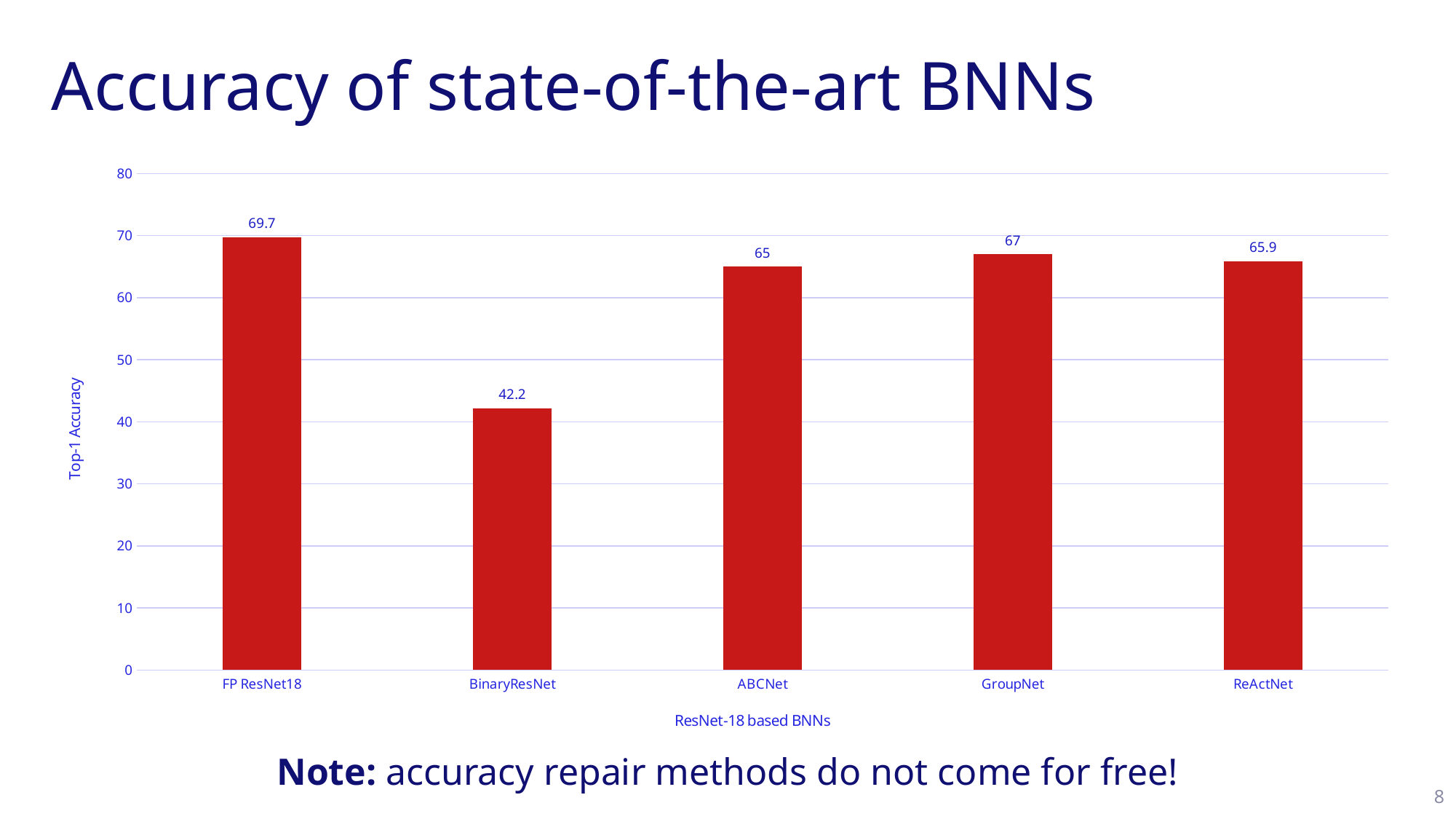
Which has a higher Top-1 Accuracy, GroupNet or ReActNet? GroupNet What is the Top-1 Accuracy for ReActNet? 65.9 Which model has the lowest Top-1 Accuracy? BinaryResNet What is the difference in Top-1 Accuracy between FP ResNet18 and BinaryResNet? 27.5 Which model has the highest Top-1 Accuracy? FP ResNet18 What is the Top-1 Accuracy for GroupNet? 67 What is the Top-1 Accuracy for BinaryResNet? 42.2 What is the difference in Top-1 Accuracy between GroupNet and ABCNet? 2 How many models are shown on the x axis? 5 What is the label of the x axis? ResNet-18 based BNNs What is the Top-1 Accuracy for FP ResNet18? 69.7 What kind of chart is shown on the slide? Bar chart